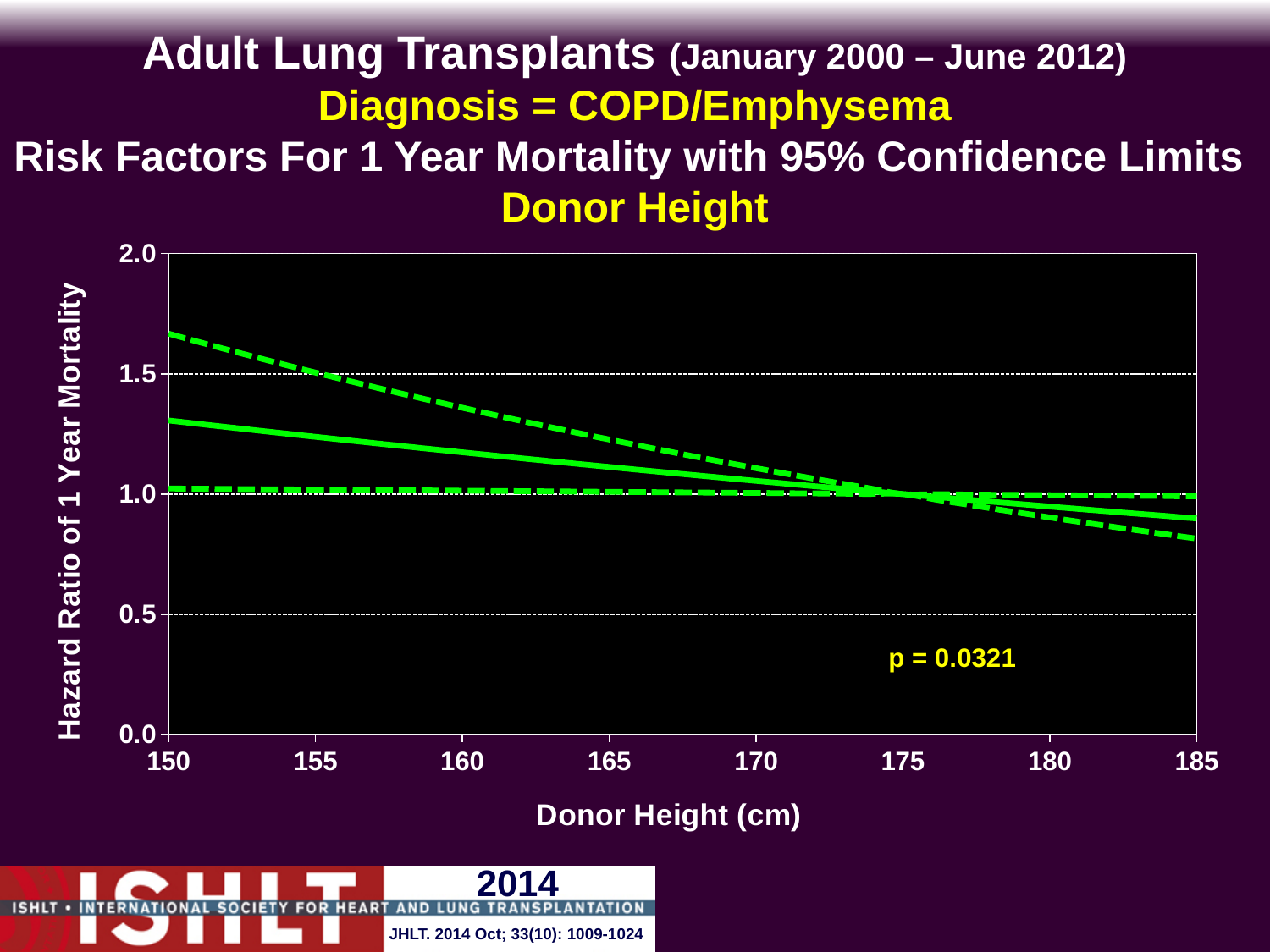
Is the upper dashed confidence limit at a donor height of 150 cm greater or less than 1.5? greater What is the label of the x axis? Donor Height (cm) Is the hazard ratio on the solid line at a donor height of 185 cm greater or less than 1.0? less Which is larger at a donor height of 150 cm: the solid hazard ratio line or the upper dashed confidence limit? the upper dashed confidence limit Is the upper dashed confidence limit at a donor height of 165 cm greater or less than 1.5? less What is the highest value shown on the y axis? 2.0 Does the solid hazard ratio line rise or fall as donor height increases from 150 cm to 185 cm? fall What kind of chart is shown on the slide? line chart What p-value is printed on the chart? p = 0.0321 How many lines are plotted on the chart? 3